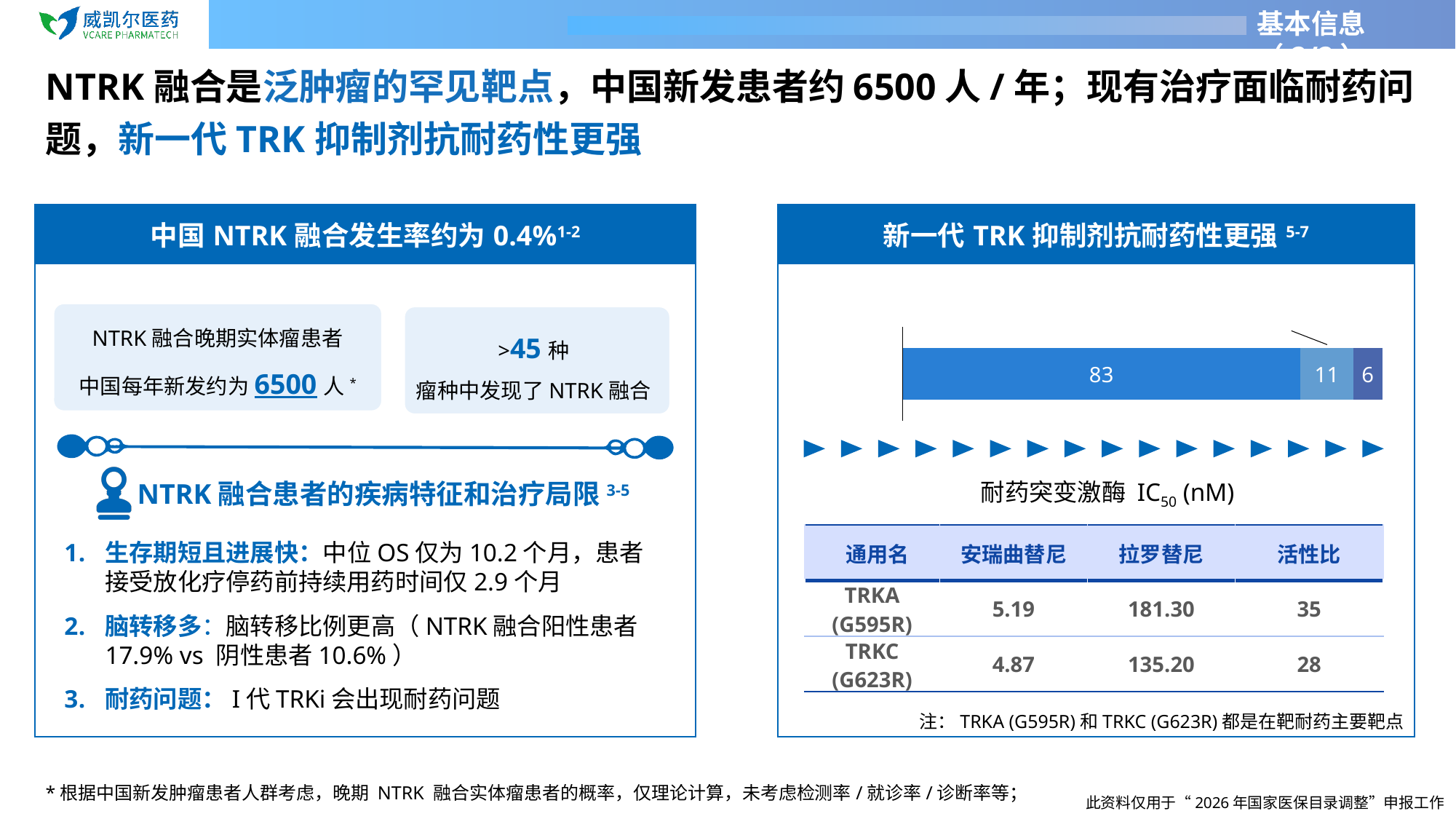
In the stacked bar chart on the right, what is the value printed on the middle segment? 11 In the stacked bar chart on the right, what is the total of all segments in the bar? 100 In the stacked bar chart on the right, how many segments make up the bar? 3 In the stacked bar chart on the right, which is larger: the middle segment or the rightmost segment? The middle segment (11) What kind of chart is shown in the right panel titled "新一代 TRK 抑制剂抗耐药性更强"? Stacked bar chart In the stacked bar chart on the right, what is the value printed on the leftmost (largest) segment? 83 In the stacked bar chart on the right, which segment has the largest value? The leftmost segment, 83 In the stacked bar chart on the right, what is the value printed on the rightmost segment? 6 What is the title of the panel containing the stacked bar chart on the right? 新一代 TRK 抑制剂抗耐药性更强 In the stacked bar chart on the right, which segment has the smallest value? The rightmost segment, 6 In the stacked bar chart on the right, what is the difference between the middle segment (11) and the rightmost segment (6)? 5 In the stacked bar chart on the right, what is the difference between the largest segment (83) and the smallest segment (6)? 77